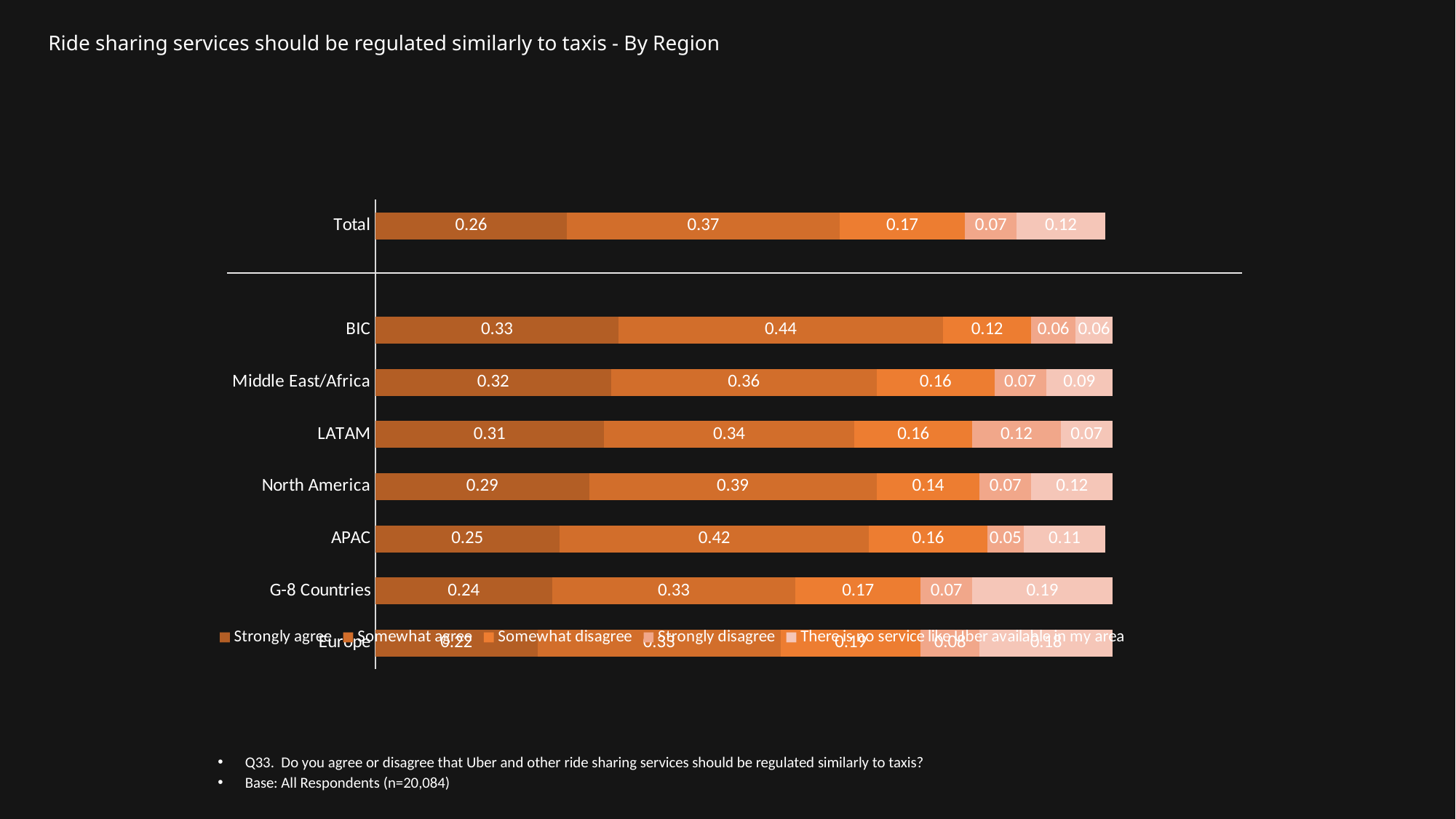
Which has the larger Strongly disagree value, LATAM or North America? LATAM What is the difference between the Somewhat agree and Strongly agree values for Total? 0.11 How many series does the legend list? 5 What is the Somewhat disagree value for Total? 0.17 What is the Strongly disagree value for APAC? 0.05 What kind of chart is shown on the slide? Stacked bar chart Which region has the highest Somewhat agree value? BIC What is the Strongly agree value for BIC? 0.33 What is the title of the chart? Ride sharing services should be regulated similarly to taxis - By Region How many categories (rows) are shown in the chart? 8 What is the Somewhat agree value for North America? 0.39 Which region has the highest Strongly agree value? BIC